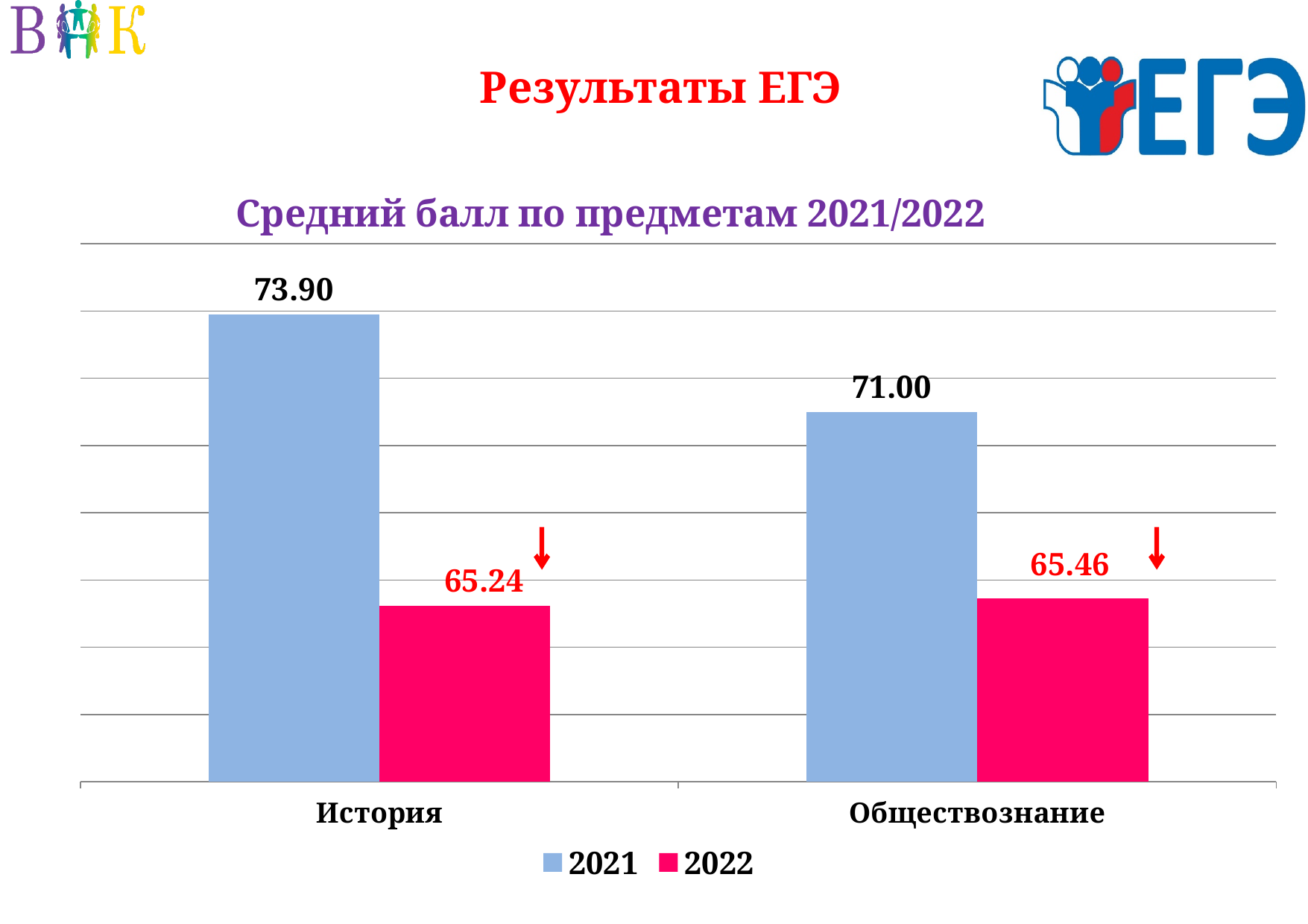
Which is larger for Обществознание: the 2021 value or the 2022 value? 2021 Which category has the lowest 2022 value? История What is the 2022 value for История? 65.24 What is the difference between the 2021 and 2022 values for История? 8.66 Which category has the highest 2021 value? История What is the 2021 value for Обществознание? 71.00 What is the 2022 value for Обществознание? 65.46 How many categories are shown on the x axis? 2 What is the difference between the 2021 and 2022 values for Обществознание? 5.54 How many series does the legend list? 2 What type of chart is shown on the slide? Bar chart What is the 2021 value for История? 73.90